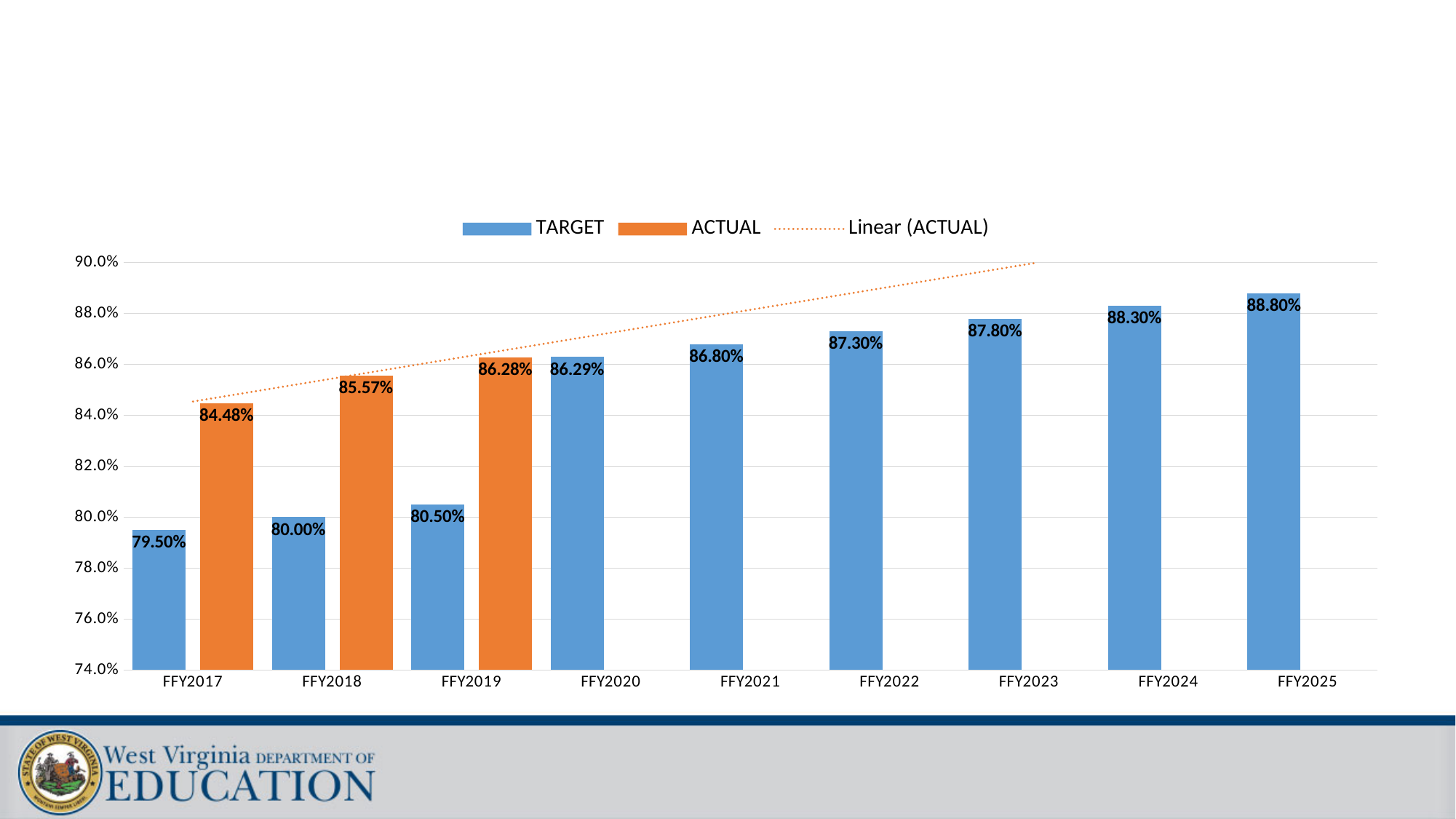
What is the TARGET value for FFY2017? 79.50% What is the ACTUAL value for FFY2019? 86.28% What is the TARGET value for FFY2025? 88.80% How many entries does the legend list? 3 What is the difference between the ACTUAL and TARGET values for FFY2017? 4.98% Which year has the lowest TARGET value? FFY2017 Which year has the highest TARGET value? FFY2025 How many years are shown on the x axis? 9 Do the TARGET values rise or fall from FFY2017 to FFY2025? Rise What kind of chart is this? Bar chart What is the ACTUAL value for FFY2018? 85.57% Which is larger for FFY2018, the TARGET or the ACTUAL value? ACTUAL